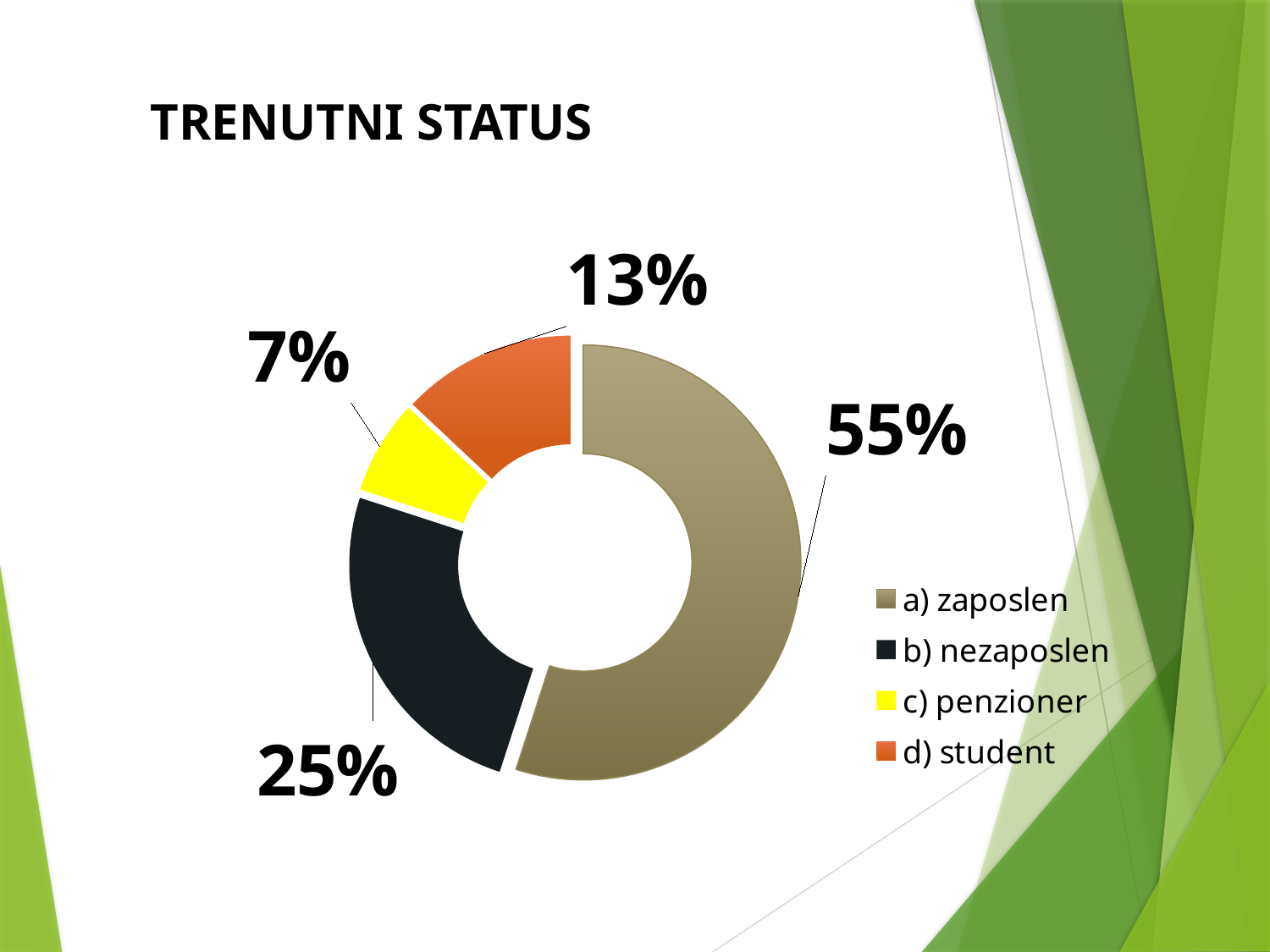
How many categories are shown in the chart? 4 What share of the chart does b) nezaposlen represent? 25% What share of the chart does a) zaposlen represent? 55% What share of the chart does d) student represent? 13% What is the difference in percentage points between d) student and c) penzioner? 6 What is the title of the chart? TRENUTNI STATUS Which category has the smallest share? c) penzioner Which category has the largest share? a) zaposlen What kind of chart is shown on the slide? Doughnut chart Which has a larger share, b) nezaposlen or d) student? b) nezaposlen What is the difference in percentage points between a) zaposlen and b) nezaposlen? 30